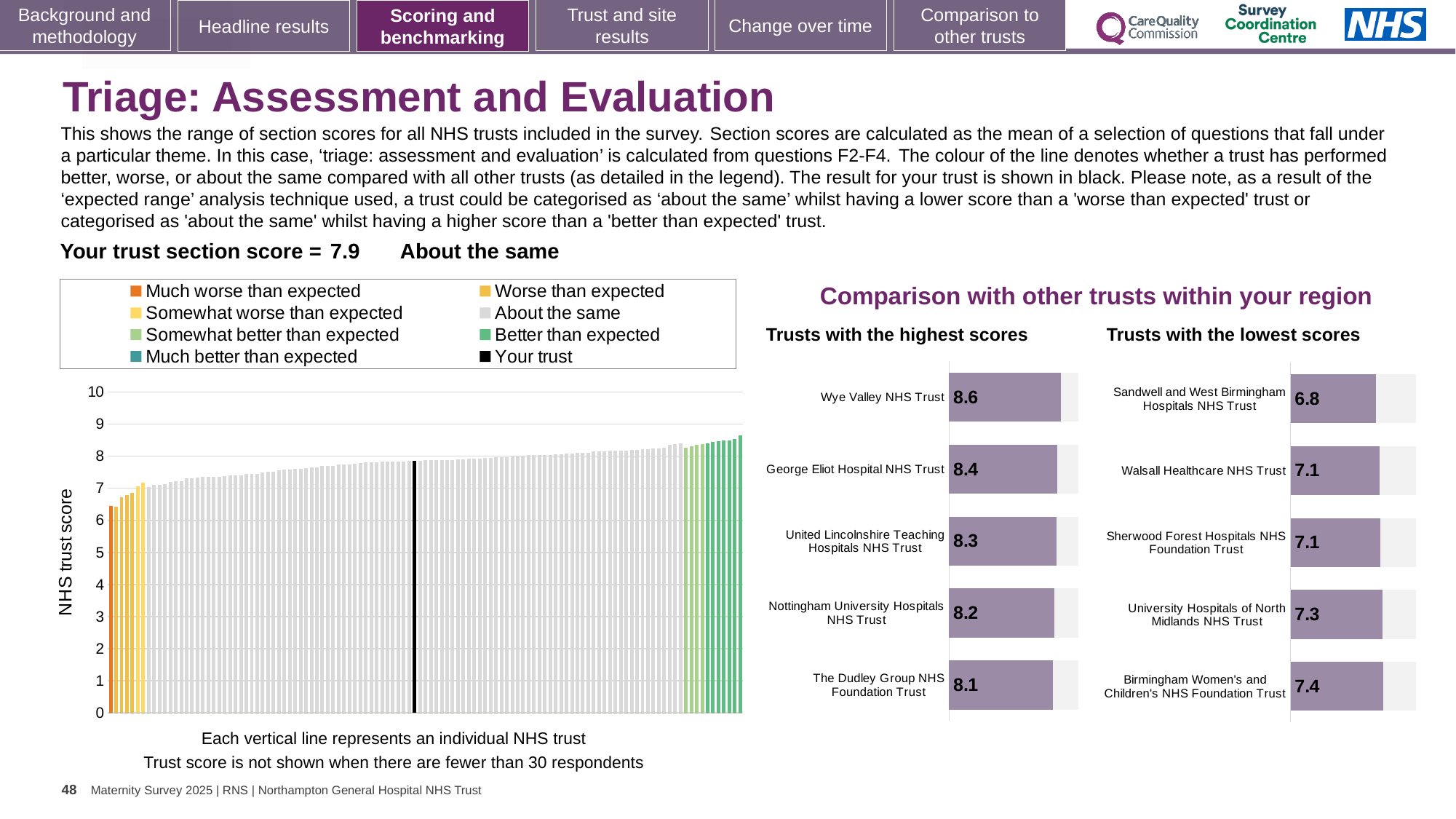
In the 'Trusts with the highest scores' chart, which trust has the lowest score shown? The Dudley Group NHS Foundation Trust What type of chart is the large chart on the left showing NHS trust scores? Bar chart In the 'Trusts with the highest scores' chart, what is the score for Wye Valley NHS Trust? 8.6 In the large chart on the left, is the value of the leftmost (lowest) bar greater or less than 7? less In the 'Trusts with the highest scores' chart, what is the difference between the scores of Wye Valley NHS Trust and The Dudley Group NHS Foundation Trust? 0.5 In the 'Trusts with the lowest scores' chart, which trust has the highest score shown? Birmingham Women's and Children's NHS Foundation Trust How many trusts are listed in the 'Trusts with the highest scores' chart? 5 How many entries does the legend of the large chart on the left list? 8 In the 'Trusts with the highest scores' chart, what is the score for Nottingham University Hospitals NHS Trust? 8.2 In the 'Trusts with the lowest scores' chart, what is the score for Sandwell and West Birmingham Hospitals NHS Trust? 6.8 In the 'Trusts with the lowest scores' chart, which has the larger score: Walsall Healthcare NHS Trust or University Hospitals of North Midlands NHS Trust? University Hospitals of North Midlands NHS Trust In the large chart on the left, do the trust scores rise or fall moving from left to right along the x axis? Rise